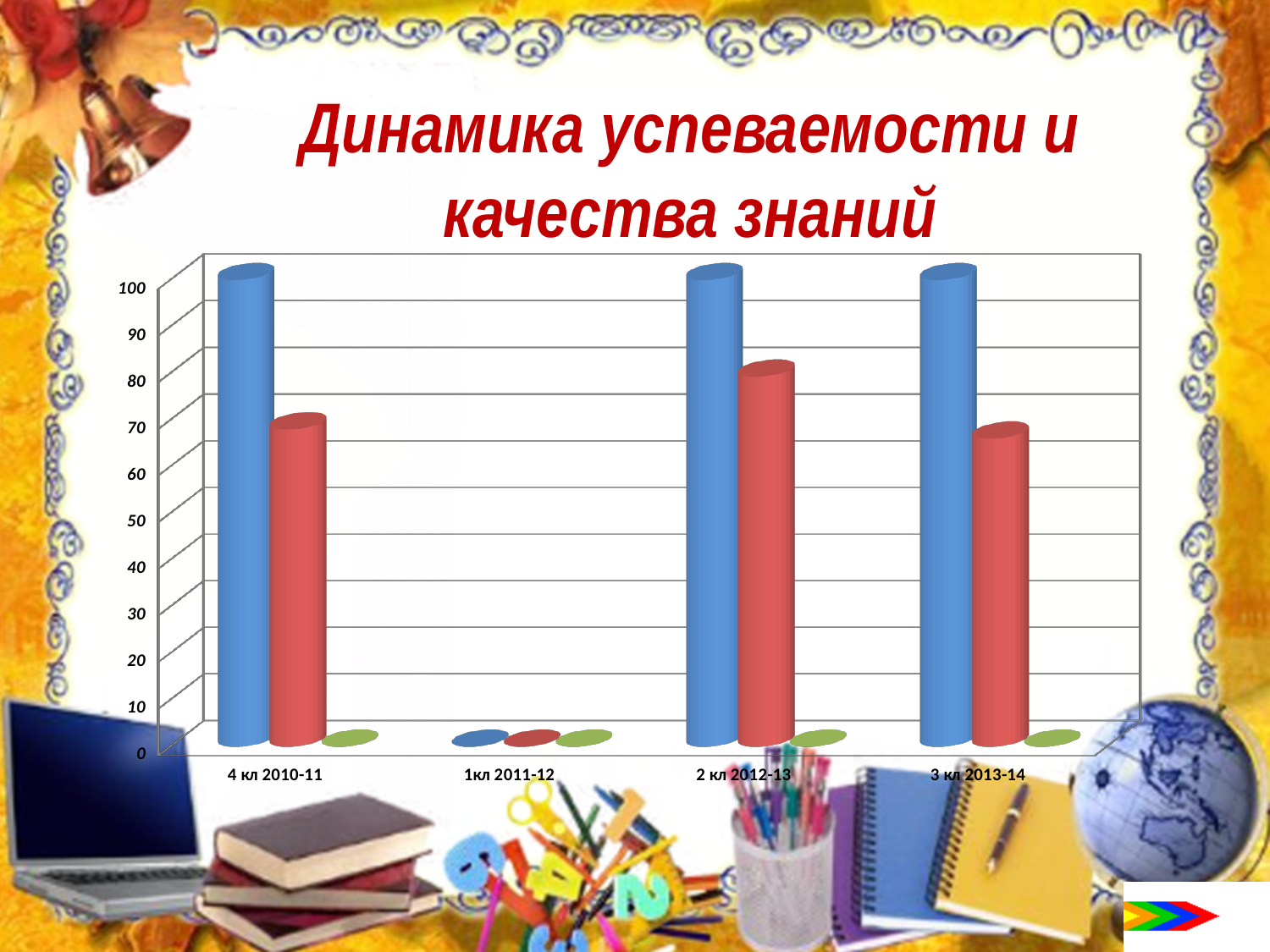
Is the red bar for 2 кл 2012-13 greater or less than 70? greater Is the red bar for 2 кл 2012-13 greater or less than 90? less Is the blue bar for 3 кл 2013-14 greater or less than 90? greater What is the title of the chart? Динамика успеваемости и качества знаний Which category has the lowest values in the chart? 1кл 2011-12 How many differently coloured bars are plotted for each category? 3 Among the red bars, which category has the highest value? 2 кл 2012-13 How many categories are shown on the x axis of the chart? 4 What kind of chart is shown on the slide? bar chart Which is larger: the red bar for 2 кл 2012-13 or the red bar for 4 кл 2010-11? 2 кл 2012-13